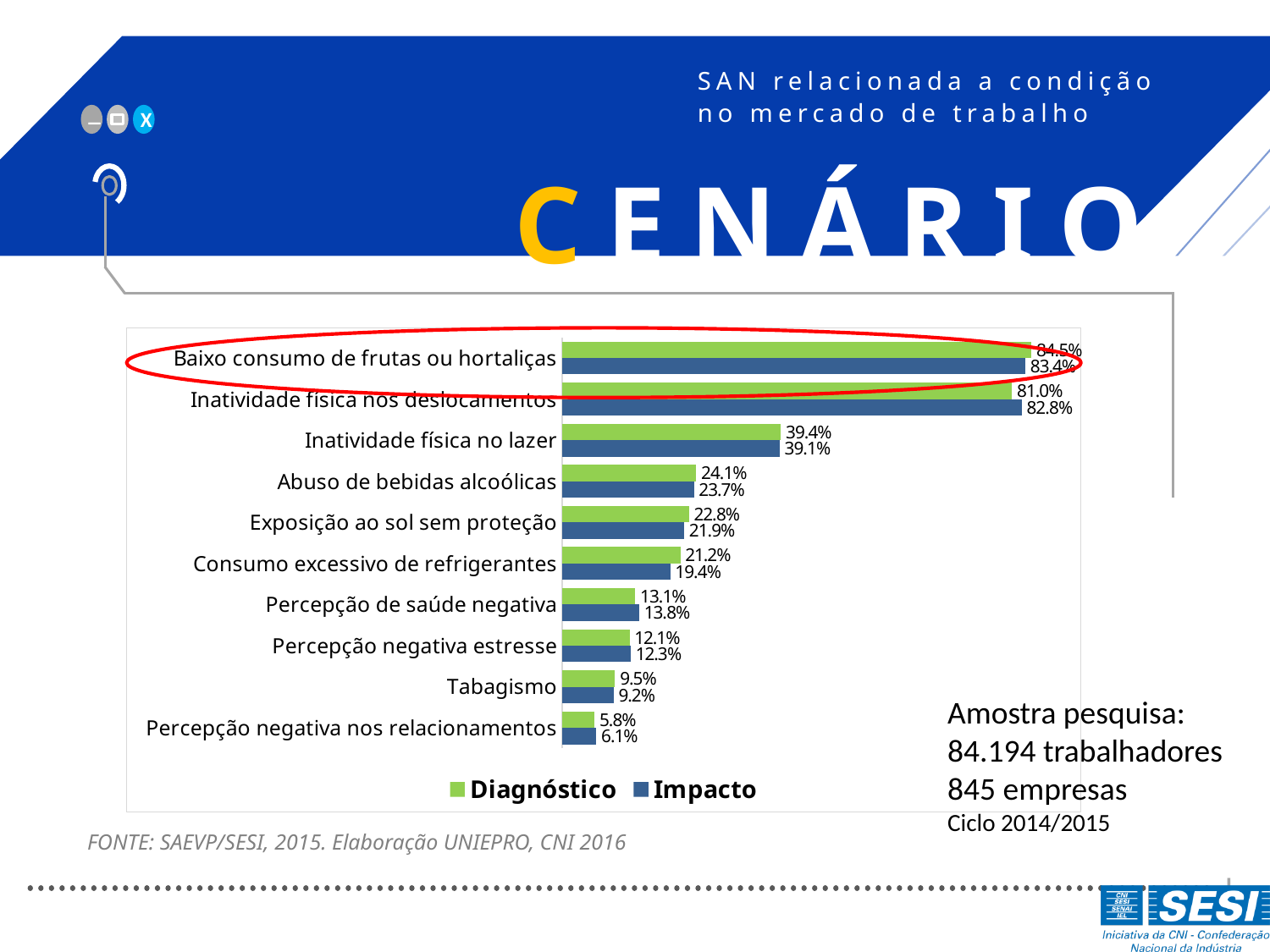
Which category has the highest Impacto value? Baixo consumo de frutas ou hortaliças Which is larger for Abuso de bebidas alcoólicas, the Diagnóstico value or the Impacto value? Diagnóstico How many categories are shown in the chart? 10 What is the Impacto value for Inatividade física nos deslocamentos? 82.8% What is the difference between the Diagnóstico and Impacto values for Consumo excessivo de refrigerantes? 1.8% What is the Impacto value for Consumo excessivo de refrigerantes? 19.4% Which category has the lowest Diagnóstico value? Percepção negativa nos relacionamentos What kind of chart is shown on the slide? Bar chart Which series is shown in green in the legend? Diagnóstico What is the Diagnóstico value for Inatividade física no lazer? 39.4% How many series does the legend list? 2 What is the Diagnóstico value for Tabagismo? 9.5%